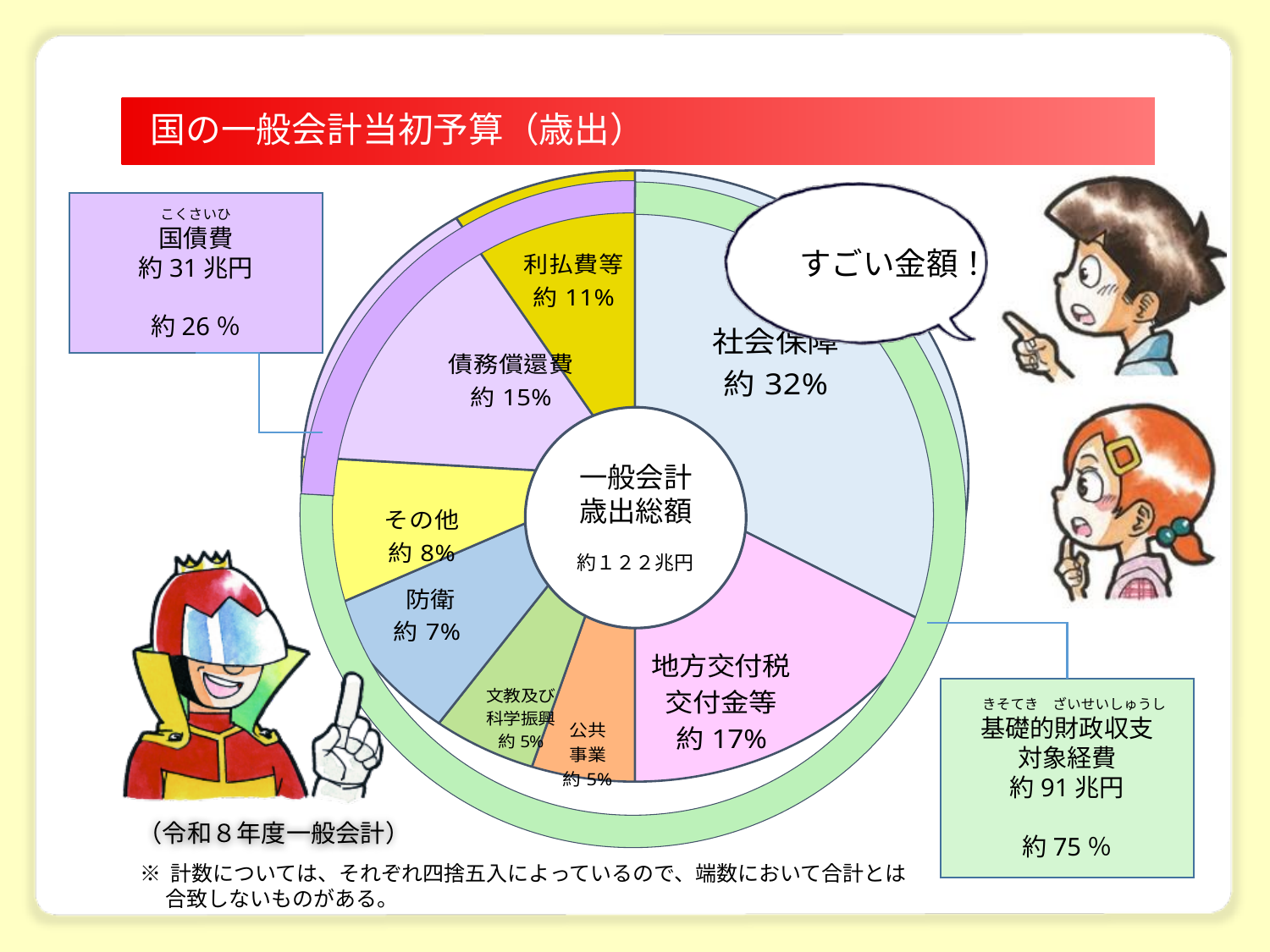
What is the share shown for 社会保障 in the pie chart? 約 32% What is the share shown for 地方交付税交付金等? 約 17% How many slices does the pie chart have? 8 Which is larger, the share for 利払費等 or the share for その他? 利払費等 What kind of chart is shown on the slide? pie chart What percentage is shown for 基礎的財政収支対象経費? 約 75 % What is the share shown for 債務償還費? 約 15% What is the share shown for 防衛? 約 7% What is the total general account expenditure shown in the centre of the chart? 約１２２兆円 What amount is shown for 国債費 in the box on the left? 約 31 兆円 What is the title of the chart on the slide? 国の一般会計当初予算（歳出） Which category has the largest share of the pie chart? 社会保障